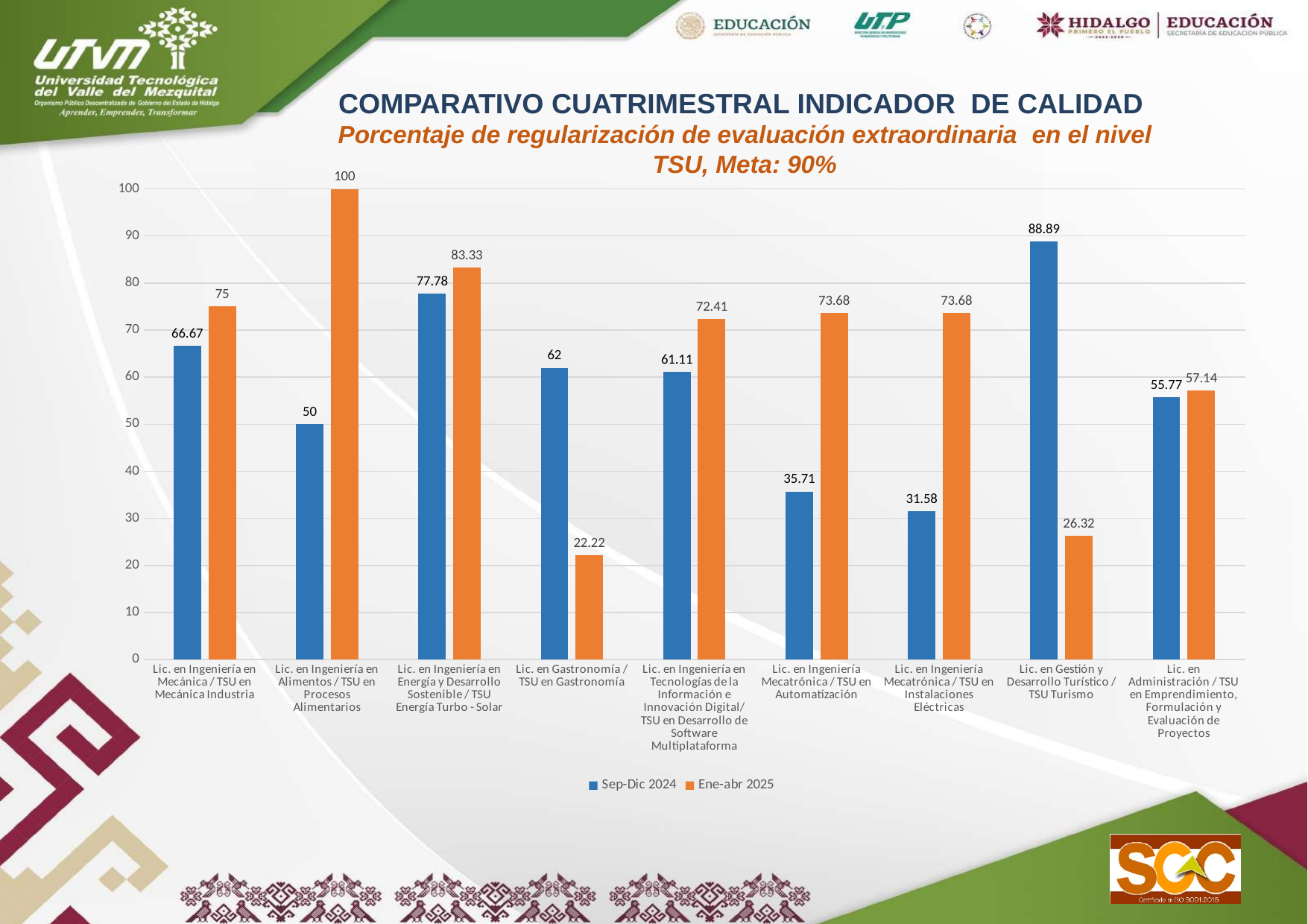
What is the Ene-abr 2025 value for Lic. en Ingeniería en Alimentos / TSU en Procesos Alimentarios? 100 Is the Sep-Dic 2024 value for Lic. en Ingeniería Mecatrónica / TSU en Automatización greater or less than 40? less What is the difference between the Ene-abr 2025 and Sep-Dic 2024 values for Lic. en Ingeniería en Alimentos / TSU en Procesos Alimentarios? 50 What is the Sep-Dic 2024 value for Lic. en Gestión y Desarrollo Turístico / TSU Turismo? 88.89 What kind of chart is shown on the slide? bar chart Which category has the lowest Ene-abr 2025 value? Lic. en Gastronomía / TSU en Gastronomía For Lic. en Gestión y Desarrollo Turístico / TSU Turismo, which series has the larger value, Sep-Dic 2024 or Ene-abr 2025? Sep-Dic 2024 Which category has the highest Sep-Dic 2024 value? Lic. en Gestión y Desarrollo Turístico / TSU Turismo How many categories are shown on the x axis of the chart? 9 How many series does the legend list? 2 What is the Ene-abr 2025 value for Lic. en Ingeniería Mecatrónica / TSU en Instalaciones Eléctricas? 73.68 What is the Sep-Dic 2024 value for Lic. en Gastronomía / TSU en Gastronomía? 62